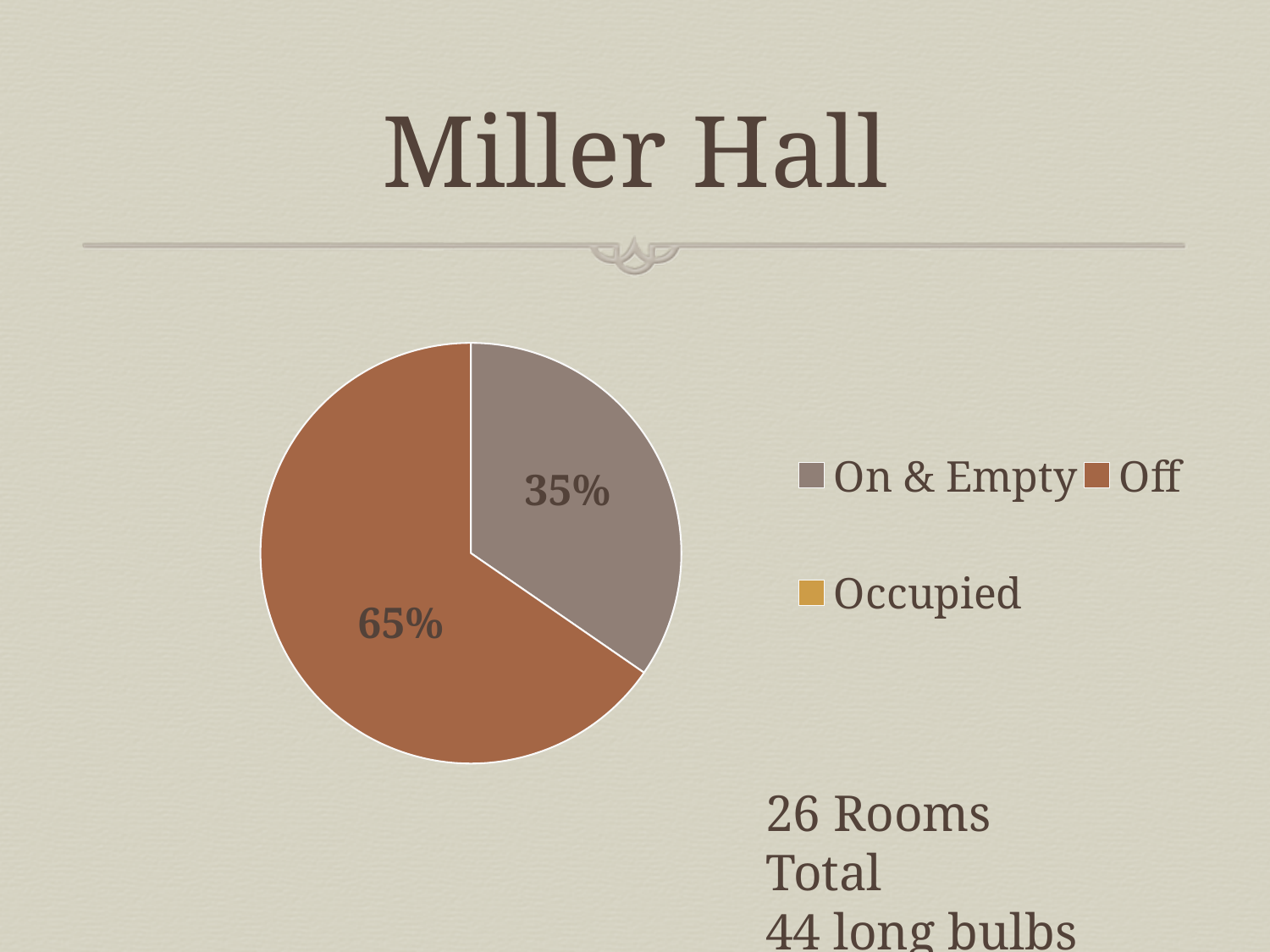
How many entries does the legend list? 3 What type of chart is shown on the slide? pie chart Which is larger, the "Off" slice or the "On & Empty" slice? Off Which of the two labelled slices is smaller, "On & Empty" or "Off"? On & Empty What percentage of the pie is labelled "Off"? 65% What share of the pie does the "Off" slice take up? 65% What percentage of the pie is labelled "On & Empty"? 35% Which slice of the pie is the largest? Off What is the difference in percentage points between the "Off" slice and the "On & Empty" slice? 30 What is the title of the slide containing the pie chart? Miller Hall How many slices with a printed percentage label are visible in the pie? 2 What colour is the "Off" slice in the pie chart? brown